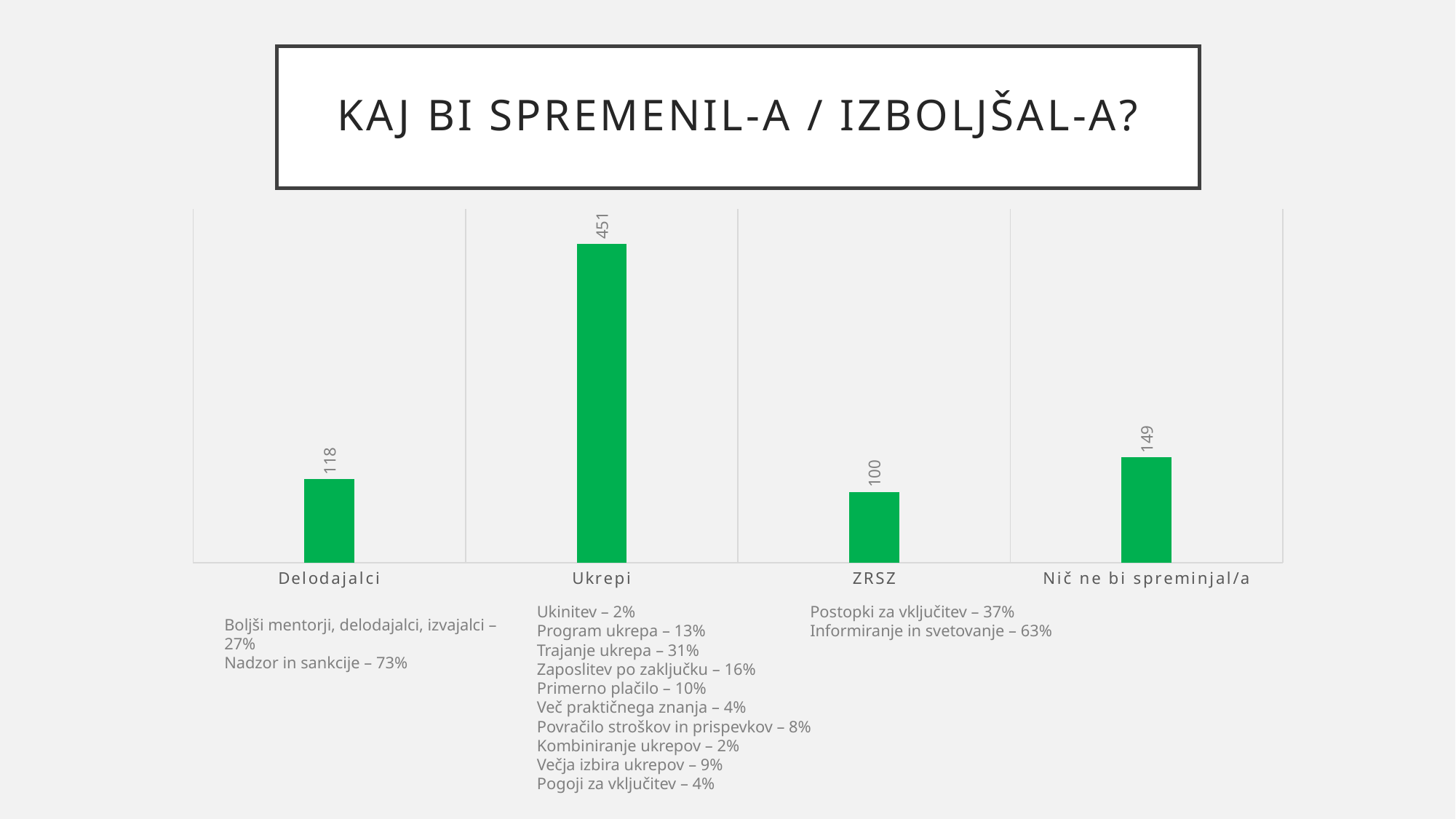
What is the value for Ukrepi? 451 What colour are the bars in the chart? Green Which category has the highest value? Ukrepi What is the value for Nič ne bi spreminjal/a? 149 What is the difference between the values for Ukrepi and Nič ne bi spreminjal/a? 302 What is the difference between the values for Delodajalci and ZRSZ? 18 What kind of chart is shown on the slide? Bar chart What is the value for ZRSZ? 100 What is the value for Delodajalci? 118 Which is larger, the value for Delodajalci or the value for Nič ne bi spreminjal/a? Nič ne bi spreminjal/a How many categories are shown in the chart? 4 Which category has the lowest value? ZRSZ